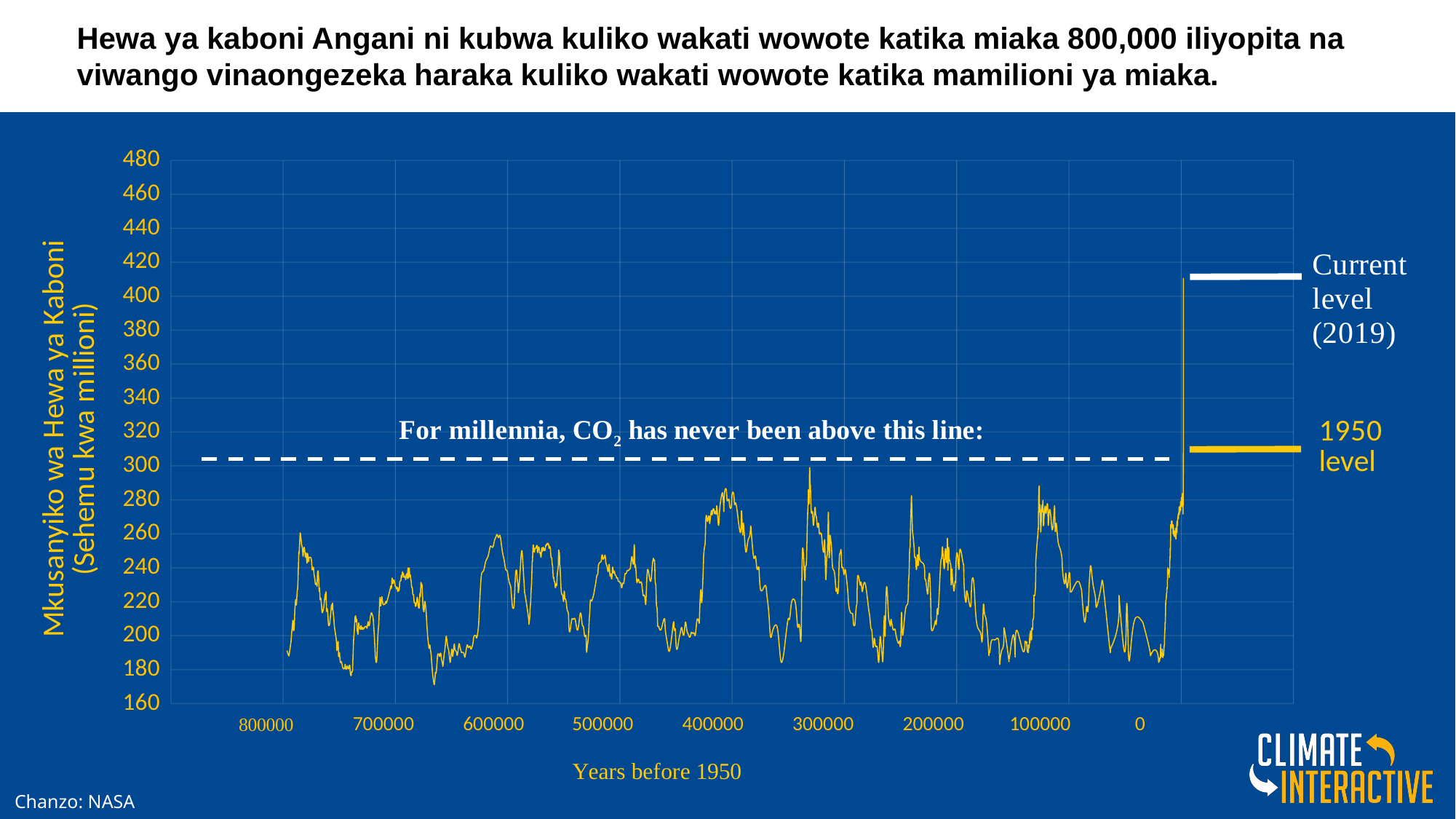
What is the label of the x axis? Years before 1950 Is the value marked as the Current level (2019) greater or less than 400? greater What is the highest value shown on the y axis? 480 Is the value of the line at 800000 years before 1950 greater or less than 220? less What kind of chart is shown on the slide? line chart Is the lowest point of the plotted line greater or less than 200? less How many labelled tick marks are there on the x axis? 9 What is the label of the y axis? Mkusanyiko wa Hewa ya Kaboni (Sehemu kwa millioni) Does the plotted line rise or fall sharply at the right-hand end of the x axis? rise Which is larger, the Current level (2019) or the 1950 level? Current level (2019)